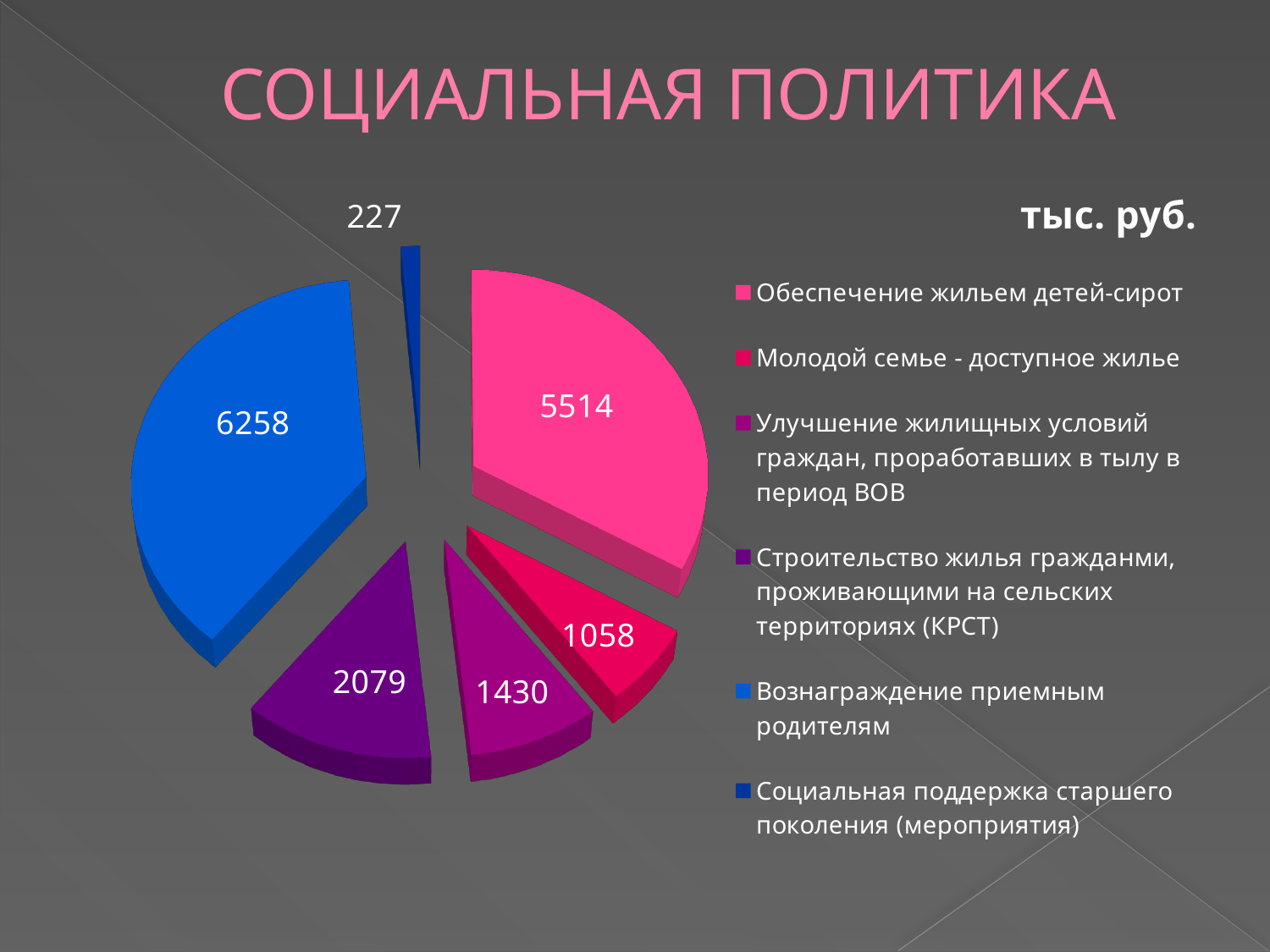
Which category has the largest slice of the pie? Вознаграждение приемным родителям What is the total of all the slices in the pie chart? 16566 What is the value for Вознаграждение приемным родителям? 6258 What is the value for Социальная поддержка старшего поколения (мероприятия)? 227 Which is larger: the value for Улучшение жилищных условий граждан, проработавших в тылу в период ВОВ or the value for Молодой семье - доступное жилье? Улучшение жилищных условий граждан, проработавших в тылу в период ВОВ What is the value for Обеспечение жильем детей-сирот? 5514 How many slices does the pie chart have? 6 What is the difference between the values for Вознаграждение приемным родителям and Обеспечение жильем детей-сирот? 744 What is the value for Строительство жилья гражданами, проживающими на сельских территориях (КРСТ)? 2079 Which category has the smallest slice of the pie? Социальная поддержка старшего поколения (мероприятия) What unit is indicated for the values in the chart? тыс. руб. What kind of chart is shown on the slide? Pie chart